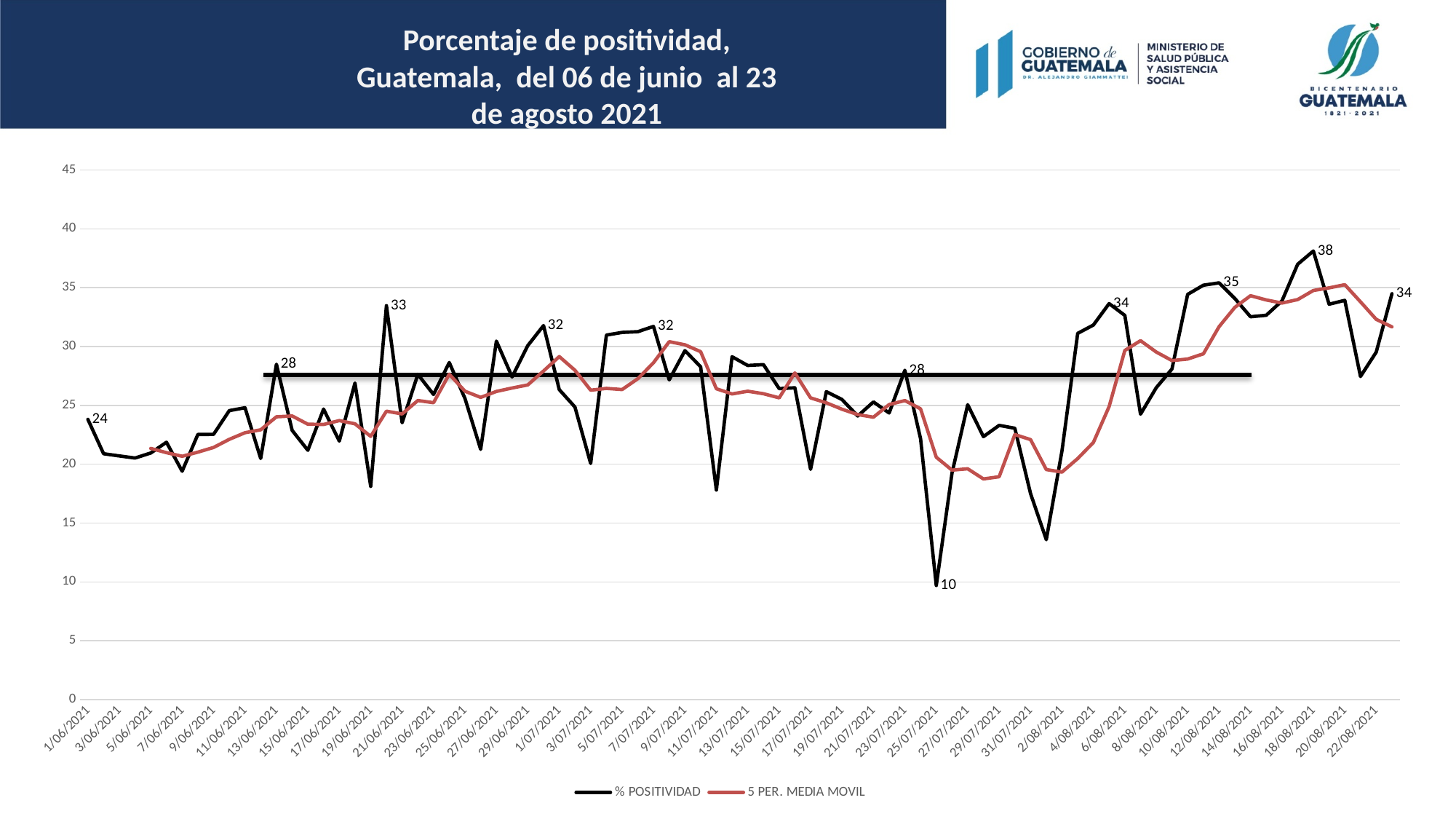
What is the labeled % POSITIVIDAD value on 1/06/2021? 24 On which date does the % POSITIVIDAD line reach its lowest labeled value? 25/07/2021 What is the labeled % POSITIVIDAD value on 18/08/2021? 38 What are the two series named in the legend? % POSITIVIDAD and 5 PER. MEDIA MOVIL On which date does the % POSITIVIDAD line reach its highest labeled value? 18/08/2021 How many series does the legend list? 2 What type of chart is shown on the slide? Line chart What is the difference between the highest labeled value (38) and the lowest labeled value (10) of % POSITIVIDAD? 28 What is the labeled % POSITIVIDAD value on 25/07/2021? 10